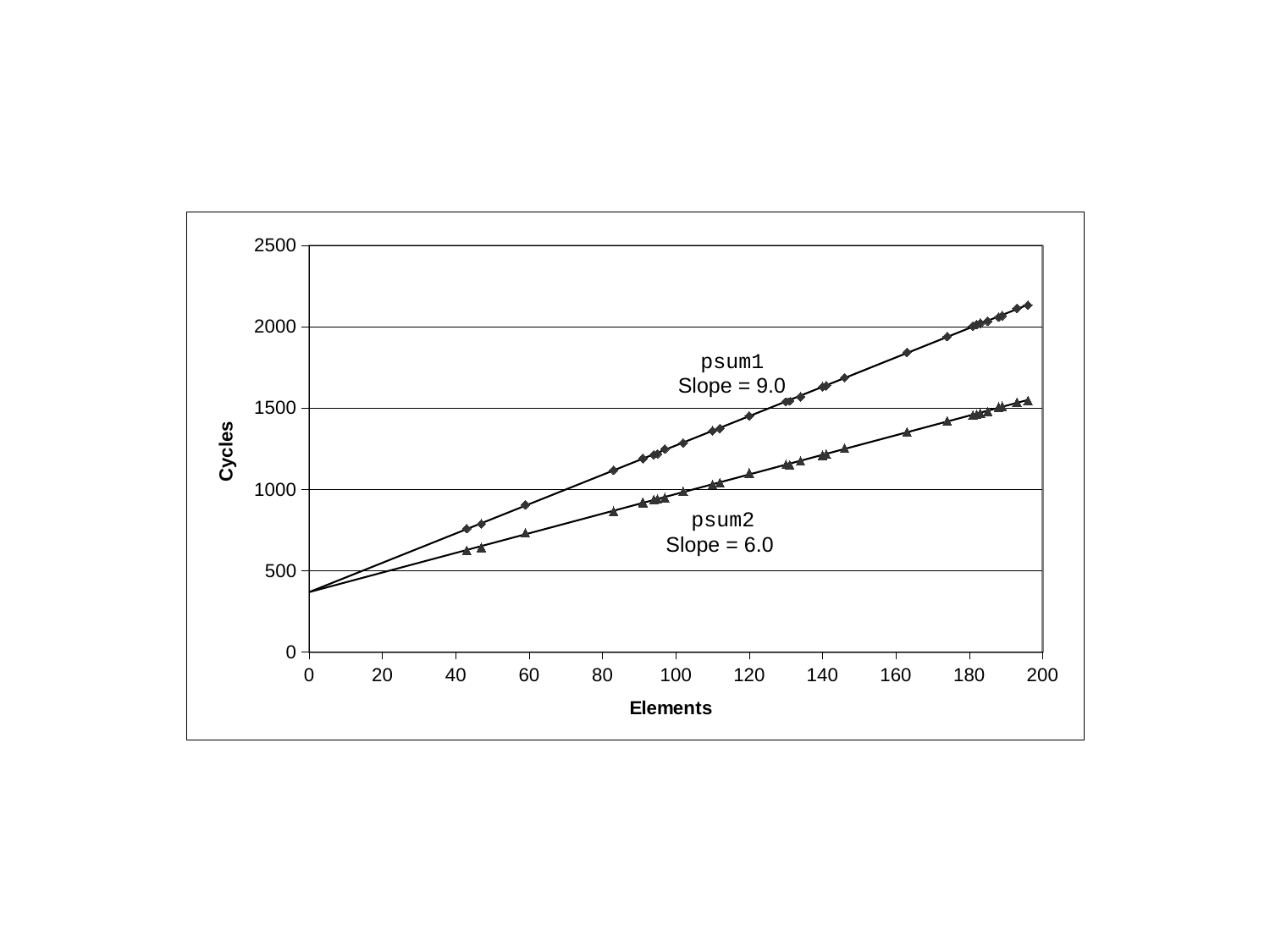
What slope is given for the psum1 series? 9.0 Is the value for psum1 at about 196 elements greater or less than 2000 cycles? greater Is the value for psum1 at about 120 elements greater or less than 1500 cycles? less Which series has the higher cycle count at 160 elements, psum1 or psum2? psum1 Is the value for psum2 at about 196 elements greater or less than 2000 cycles? less Do the cycle counts for psum1 rise or fall as the number of elements increases? rise What is the label of the x axis? Elements How many data series are plotted on the chart? 2 What slope is given for the psum2 series? 6.0 What is the label of the y axis? Cycles What kind of chart is shown on the slide? scatter chart